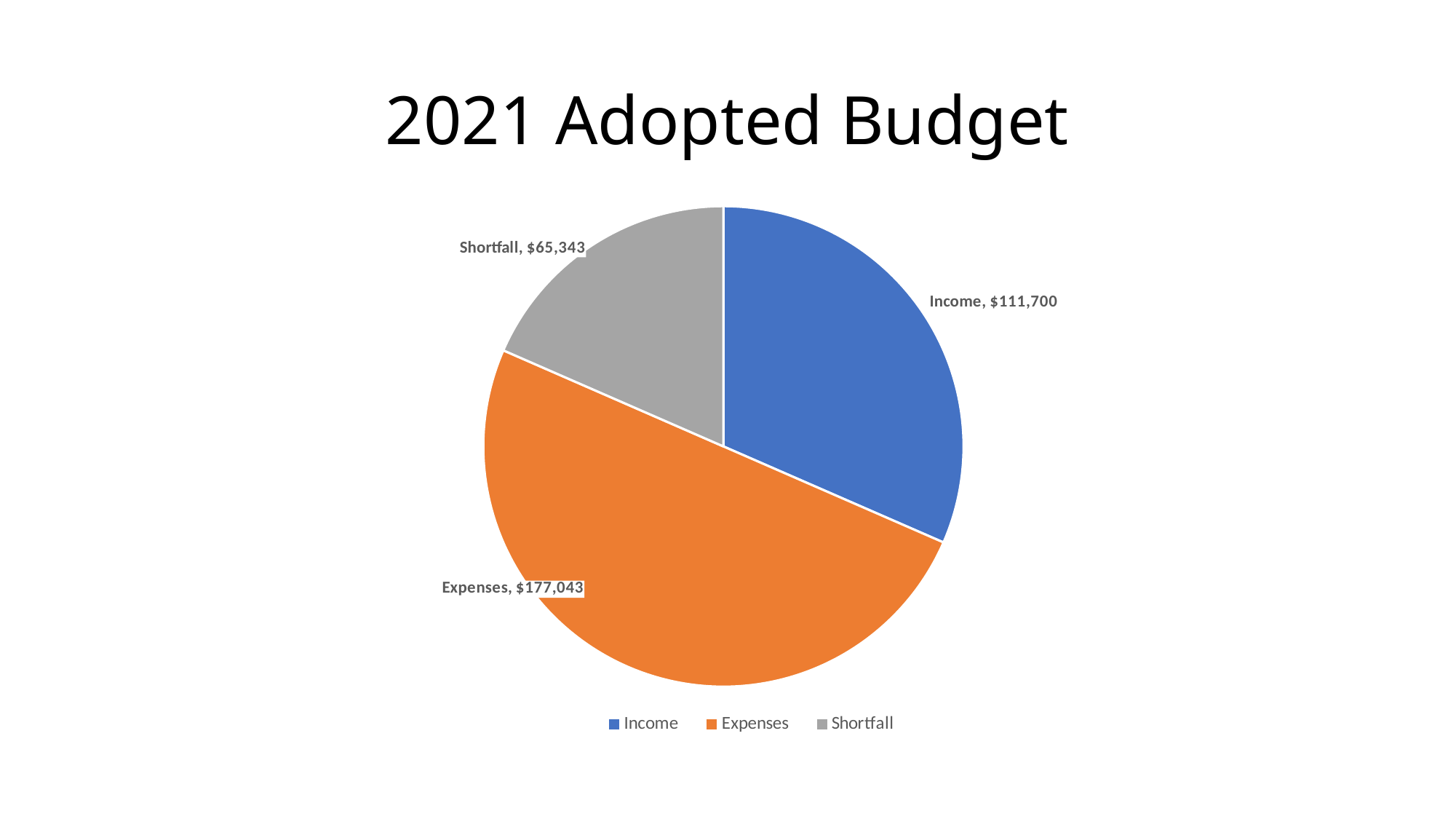
What is the difference between Income and Shortfall? $46,357 What is the title of the chart? 2021 Adopted Budget How many slices does the pie chart have? 3 Which category has the smallest slice? Shortfall What kind of chart is shown on the slide? Pie chart Which category has the largest slice? Expenses What is the value of the Expenses slice? $177,043 Which is larger, Income or Shortfall? Income What colour is the Expenses slice? Orange What is the value of the Income slice? $111,700 What is the difference between Expenses and Income? $65,343 What is the value of the Shortfall slice? $65,343